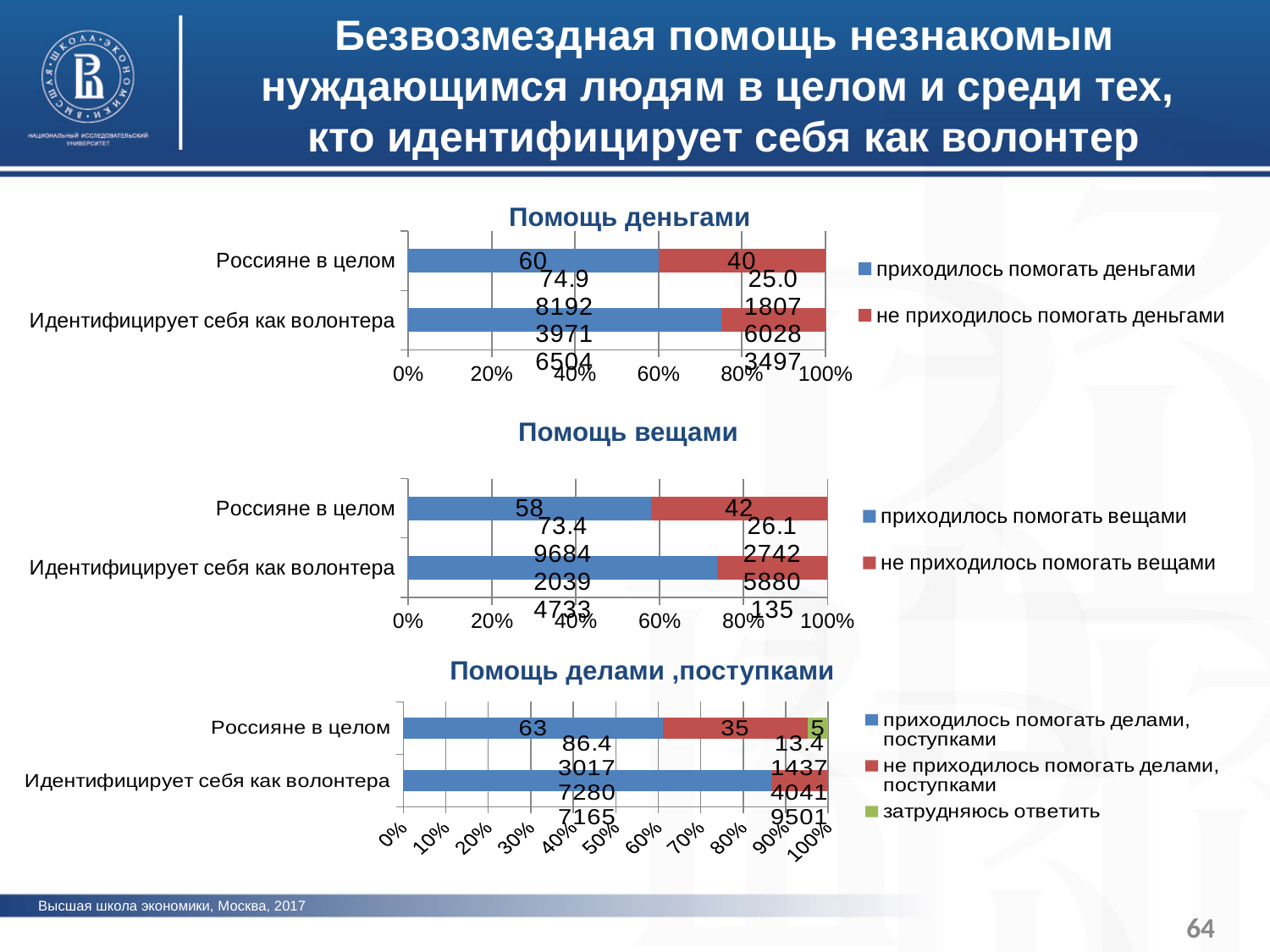
In the 'Помощь делами ,поступками' chart, what is the value for 'Россияне в целом' in the series 'приходилось помогать делами, поступками'? 63 What kind of chart is the 'Помощь деньгами' chart? Stacked bar chart How many categories are shown on the vertical axis of the 'Помощь вещами' chart? 2 In the 'Помощь деньгами' chart, what is the value for 'Россияне в целом' in the series 'не приходилось помогать деньгами'? 40 In the 'Помощь деньгами' chart, what is the value for 'Россияне в целом' in the series 'приходилось помогать деньгами'? 60 In the 'Помощь вещами' chart, what is the difference between the 'приходилось помогать вещами' and 'не приходилось помогать вещами' values for 'Россияне в целом'? 16 How many series does the legend of the 'Помощь деньгами' chart list? 2 How many series does the legend of the 'Помощь делами ,поступками' chart list? 3 In the 'Помощь деньгами' chart, which category has the larger share for 'приходилось помогать деньгами': 'Россияне в целом' or 'Идентифицирует себя как волонтера'? Идентифицирует себя как волонтера In the 'Помощь делами ,поступками' chart, what is the value for 'Россияне в целом' in the series 'затрудняюсь ответить'? 5 In the 'Помощь вещами' chart, what is the value for 'Россияне в целом' in the series 'не приходилось помогать вещами'? 42 In the 'Помощь вещами' chart, what is the value for 'Россияне в целом' in the series 'приходилось помогать вещами'? 58